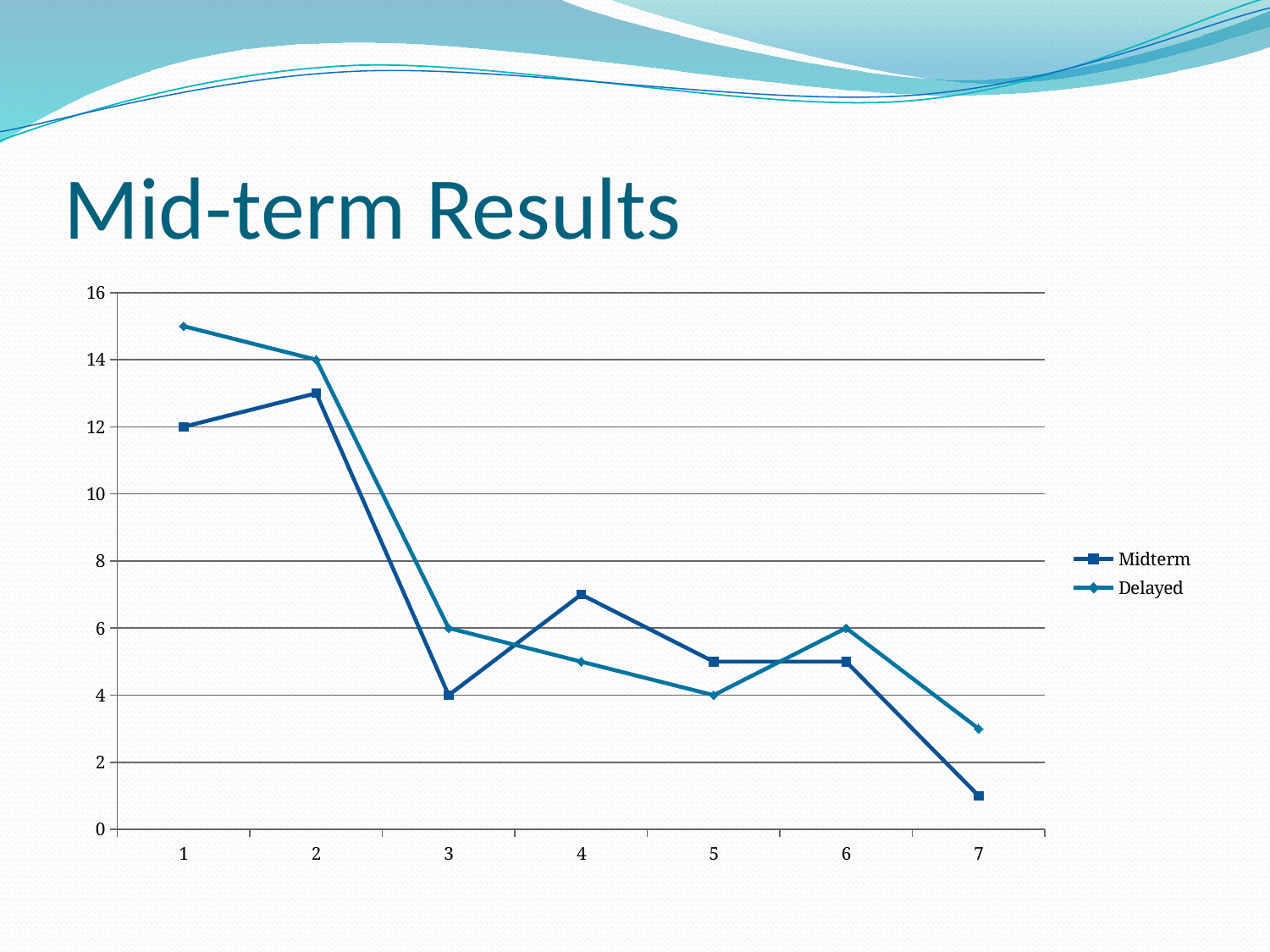
What is the Midterm value at x = 1? 12 What is the Delayed value at x = 2? 14 How many points are plotted along the x axis for each series? 7 How many series does the legend list? 2 What is the difference between the Delayed value at x = 2 and the Delayed value at x = 3? 8 At x = 4, which series has the larger value, Midterm or Delayed? Midterm What is the Midterm value at x = 3? 4 Is the Delayed value at x = 1 greater or less than 14? greater At which x value is the Midterm series lowest? 7 What kind of chart is shown on the slide? line chart What is the Delayed value at x = 3? 6 Is the Midterm value at x = 7 greater or less than 2? less